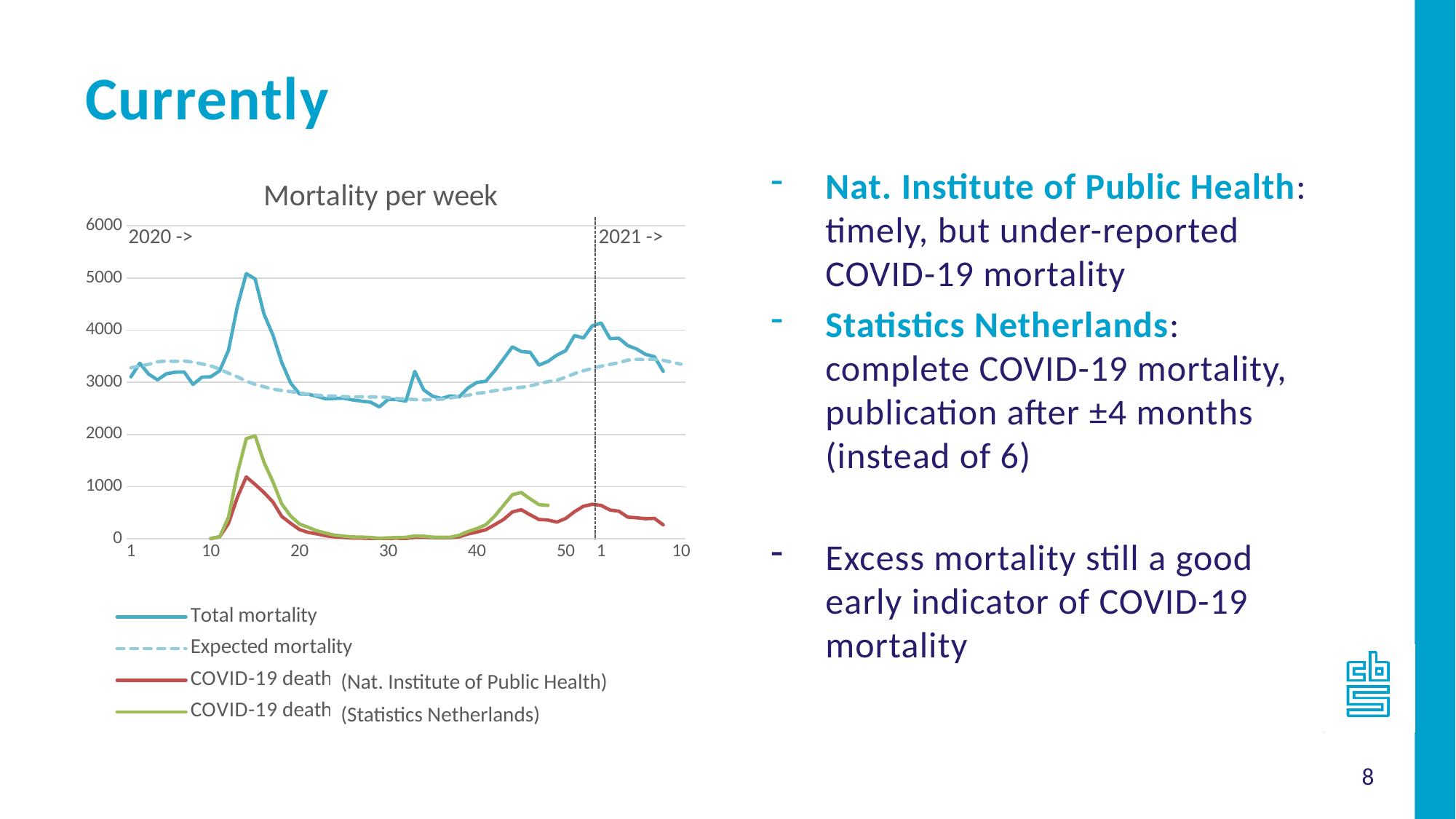
Does Expected mortality rise or fall between week 40 of 2020 and week 1 of 2021? rise Does Expected mortality ever exceed 4000 on the chart? No Is the peak value of Total mortality in 2020 greater or less than 4000? greater How many series does the chart's legend list? 4 At the spring 2020 peak, which is higher: COVID-19 death (Statistics Netherlands) or COVID-19 death (Nat. Institute of Public Health)? COVID-19 death (Statistics Netherlands) What is the title of the chart? Mortality per week Is the value of Total mortality around week 30 of 2020 greater or less than 3000? less Which series is drawn with a dashed line? Expected mortality Which series reaches the highest value on the chart? Total mortality Does Total mortality rise or fall between week 15 and week 25 of 2020? fall What kind of chart is shown on the slide? line chart